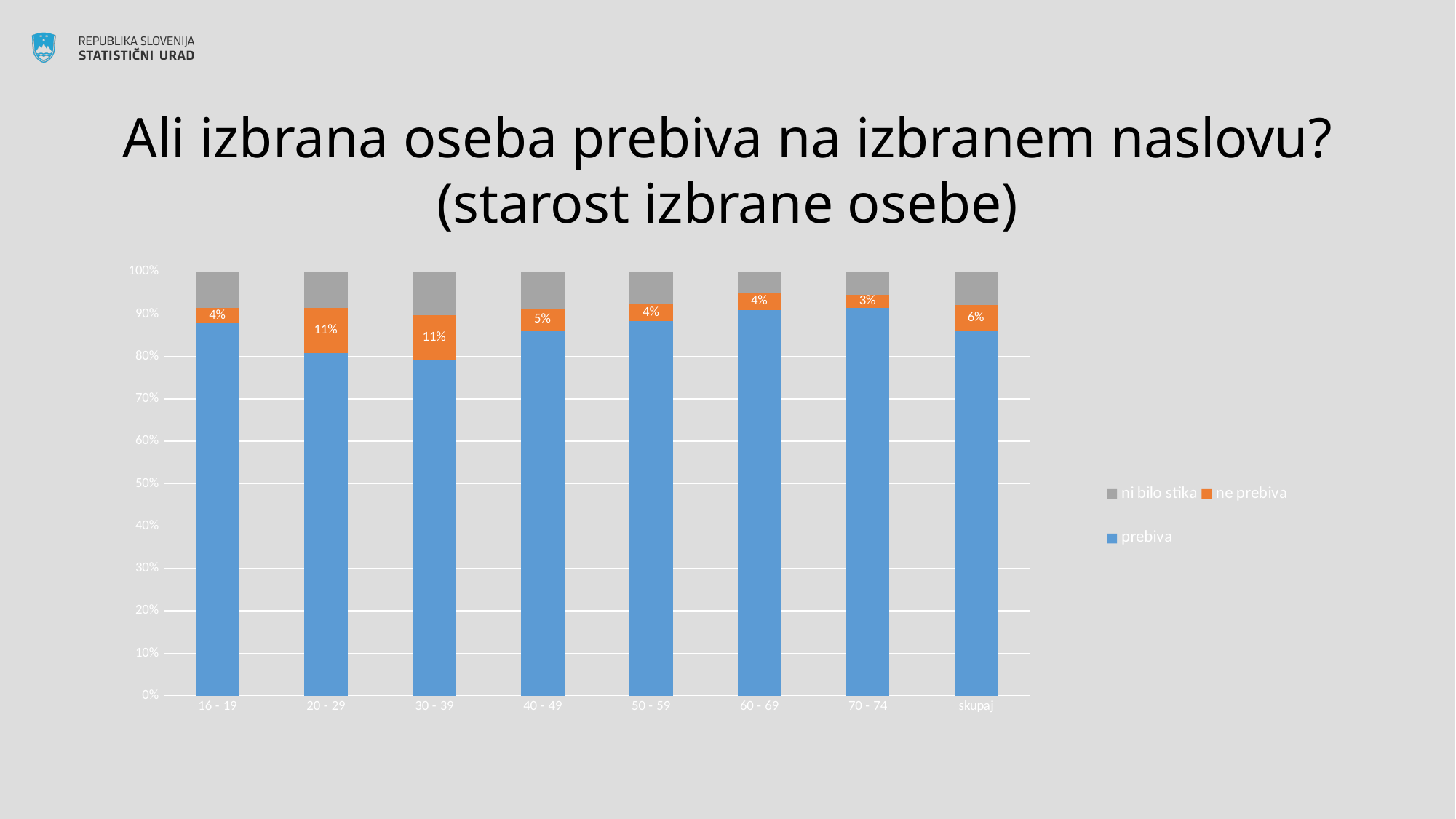
What is the value for 'ne prebiva' in the 20 - 29 age group? 11% What is the value for 'ne prebiva' in the 'skupaj' category? 6% What kind of chart is shown on the slide? stacked bar chart What is the value for 'ne prebiva' in the 70 - 74 age group? 3% What is the value for 'ne prebiva' in the 40 - 49 age group? 5% Which age group has the lowest 'ne prebiva' value? 70 - 74 Is the value for 'prebiva' in the 20 - 29 age group greater or less than 70%? greater Which has a larger 'ne prebiva' value, 20 - 29 or 40 - 49? 20 - 29 What is the difference between the 'ne prebiva' values for 30 - 39 and 16 - 19? 7 percentage points Which colour represents 'ni bilo stika' in the legend? grey How many series does the legend list? 3 How many categories are shown on the x axis? 8